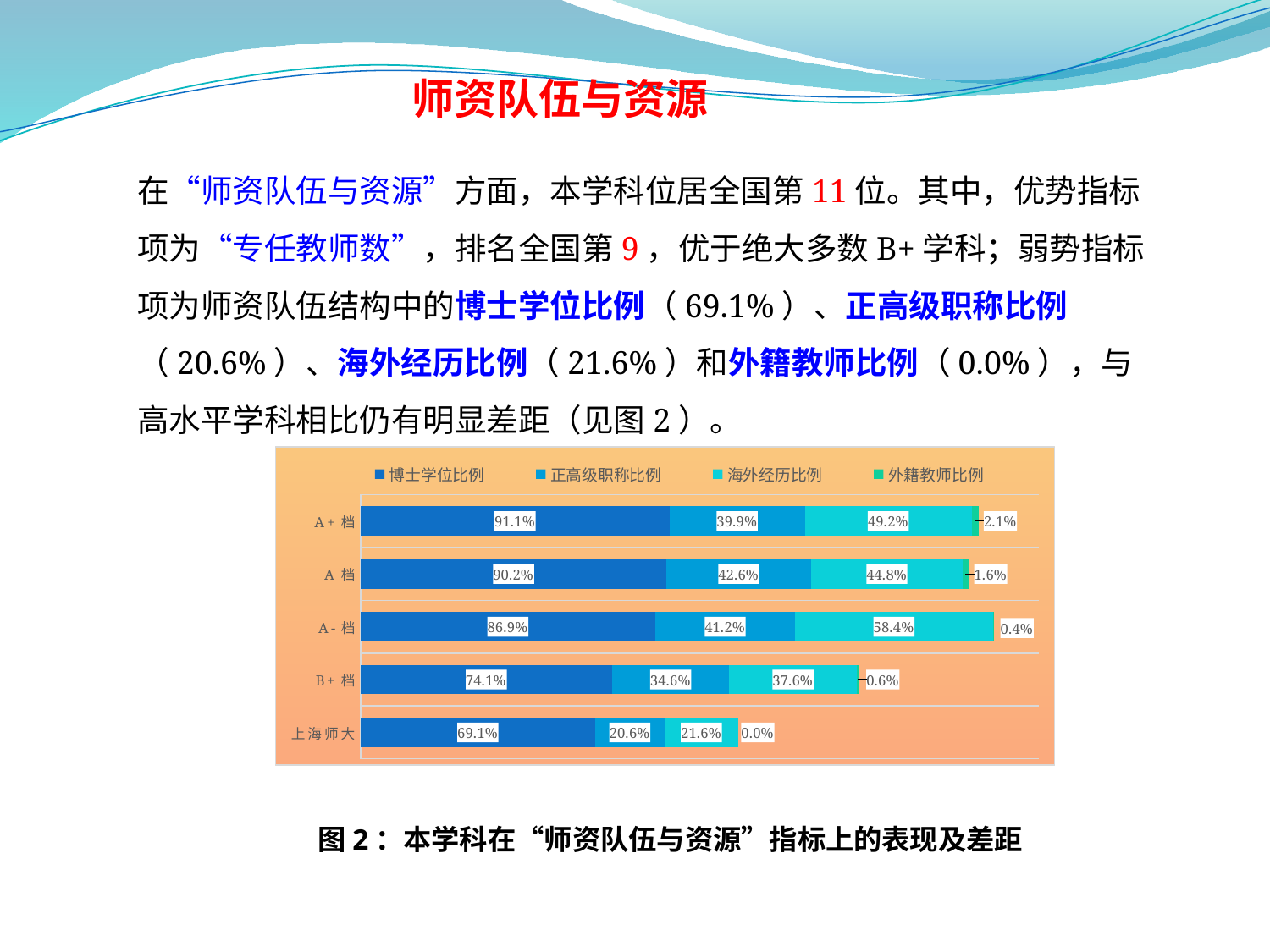
What is the 博士学位比例 value for 上海师大? 69.1% Which is larger, the 正高级职称比例 for A档 or for A+档? A档 What is the 外籍教师比例 value for B+档? 0.6% Which category has the lowest 海外经历比例? 上海师大 What is the difference in 博士学位比例 between A+档 and 上海师大? 22.0% How many series does the legend of the chart list? 4 What is the 正高级职称比例 value for A档? 42.6% How many categories (档次) are shown on the chart's vertical axis? 5 What is the 海外经历比例 value for A-档? 58.4% Which series is shown in the darkest blue colour in the chart? 博士学位比例 Which category has the highest 博士学位比例? A+档 What type of chart is shown in Figure 2? Stacked bar chart